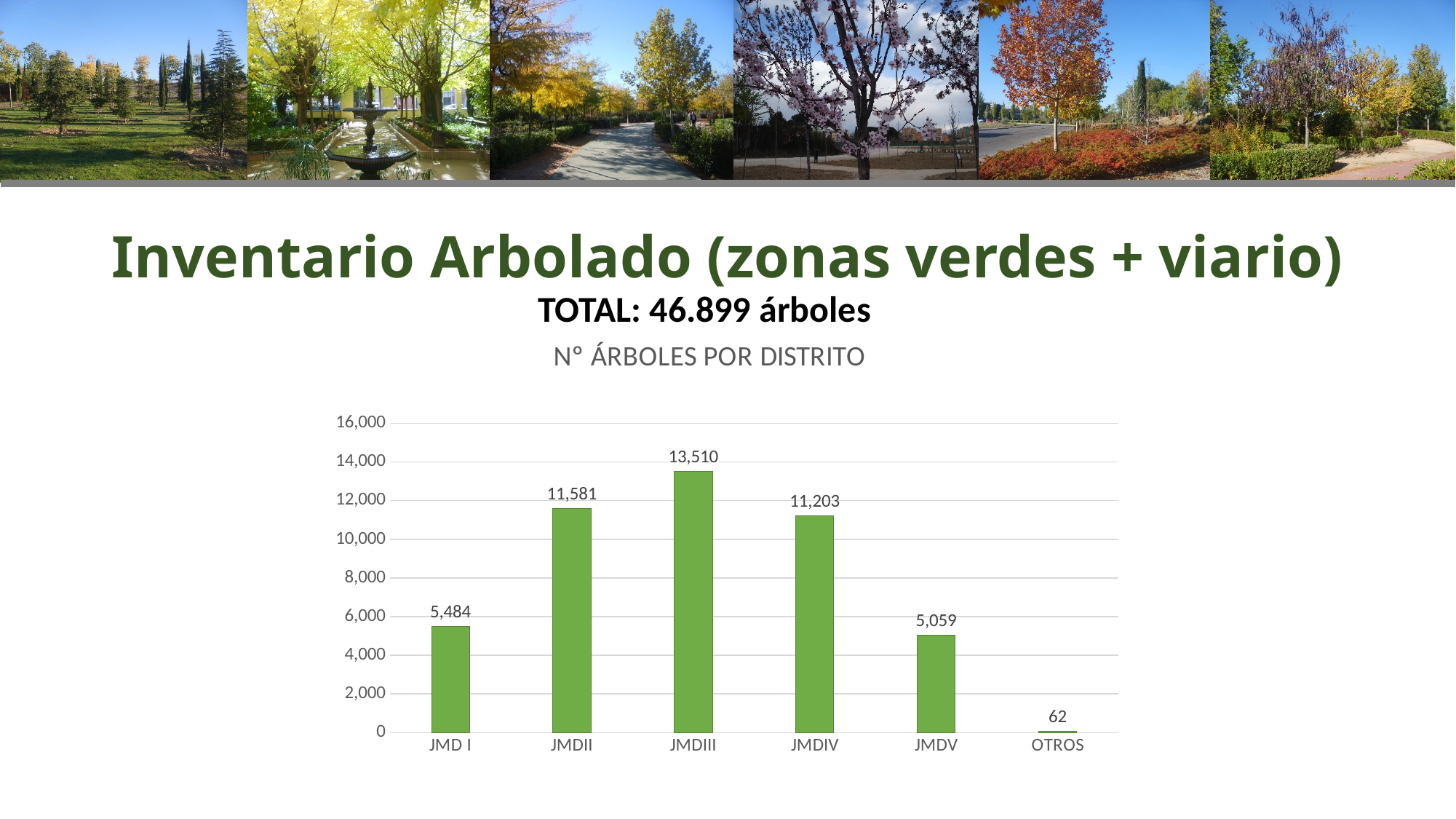
How many categories are shown on the x axis? 6 Which district has the highest number of trees? JMDIII Is the value for JMDV greater or less than 6,000? less What kind of chart is shown on the slide? bar chart What is the number of trees for JMDIII? 13,510 Which is larger, the value for JMDII or the value for JMDIV? JMDII What is the title of the chart? Nº ÁRBOLES POR DISTRITO What is the difference between the values for JMD I and JMDV? 425 What is the difference between the values for JMDII and JMDIV? 378 What is the number of trees for JMD I? 5,484 What is the value shown for OTROS? 62 Which category has the lowest value? OTROS